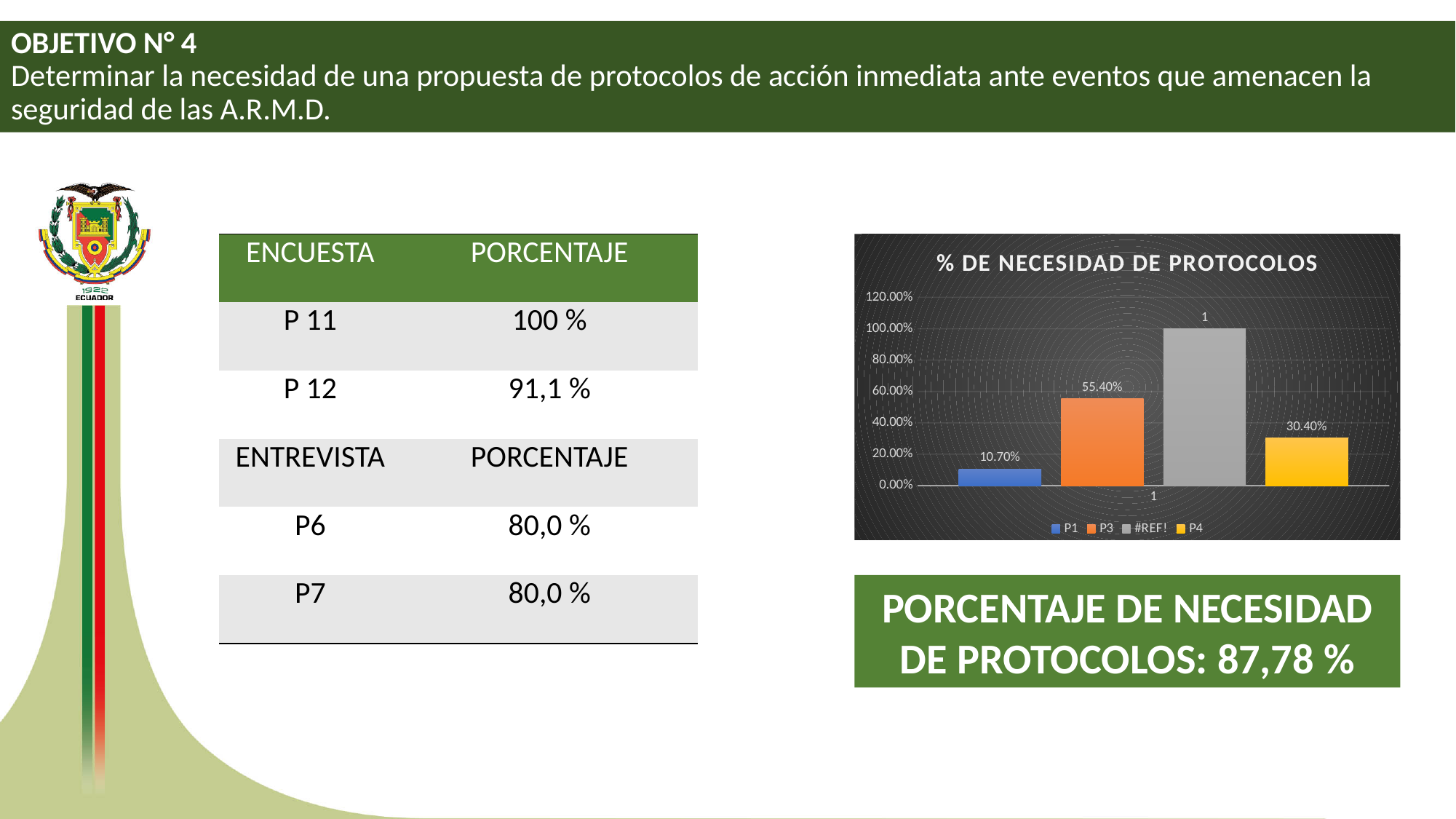
Is the value for P4 greater or less than 40.00%? less How many series does the chart legend list? 4 What data label is shown on the #REF! bar? 1 What type of chart is shown on the slide? bar chart Which series has the tallest bar in the chart? #REF! What is the value shown for the P3 series? 55.40% What is the value shown for the P1 series? 10.70% What is the value shown for the P4 series? 30.40% Which is larger, the value for P3 or the value for P4? P3 What is the title of the chart? % DE NECESIDAD DE PROTOCOLOS What is the difference between the P3 value and the P4 value? 25.00% Which series has the lowest value in the chart? P1